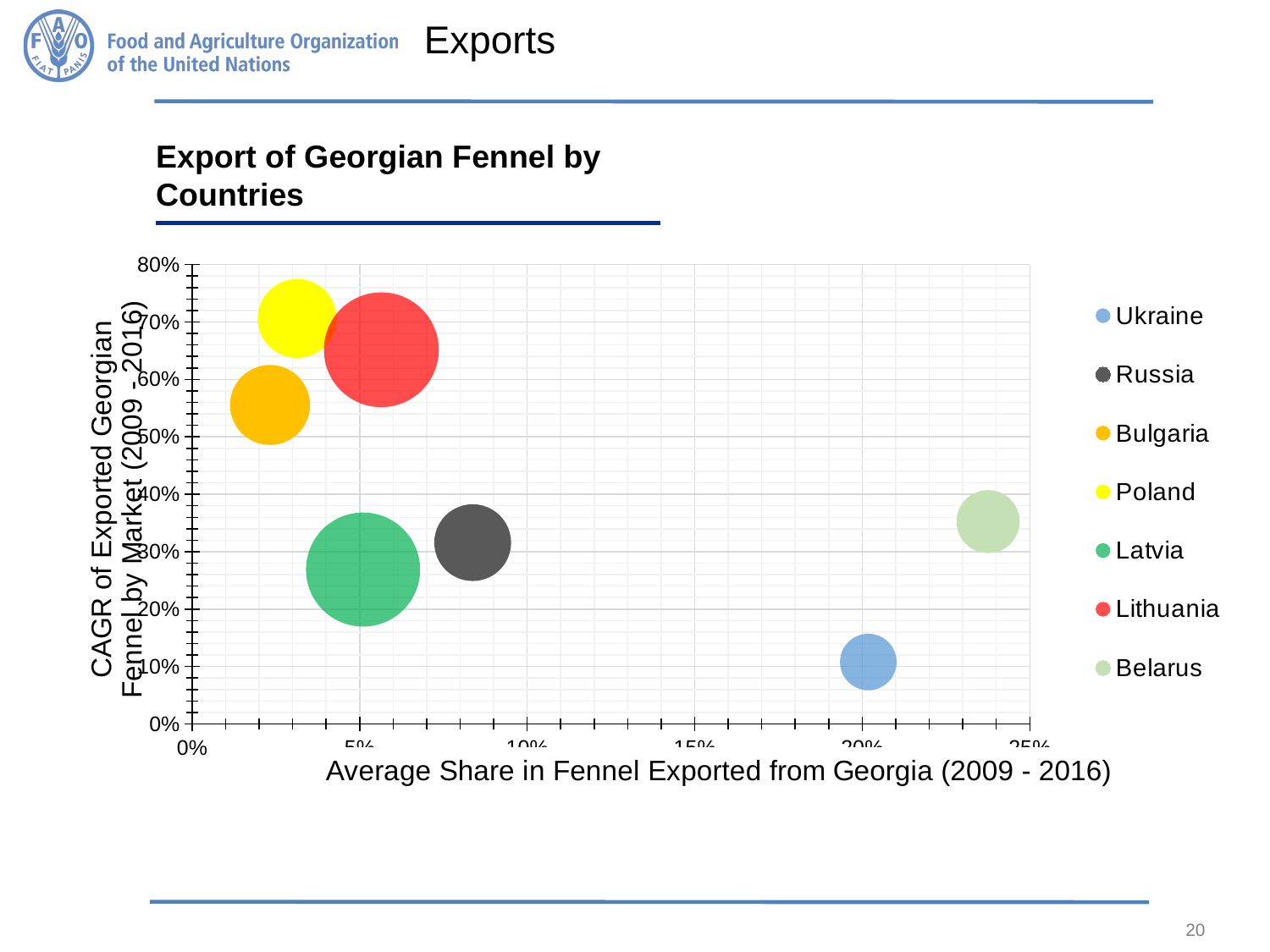
Which has a larger average share in fennel exported from Georgia, Ukraine or Russia? Ukraine What is the title of the chart? Export of Georgian Fennel by Countries Is the CAGR value for Poland greater or less than 60%? greater What kind of chart is shown on the slide? Bubble chart Is the CAGR value for Ukraine greater or less than 20%? less Which country has the highest CAGR of exported Georgian fennel? Poland How many countries does the legend list? 7 Which country has the highest average share in fennel exported from Georgia? Belarus Is the average share value for Belarus greater or less than 20%? greater Which has a higher CAGR of exported Georgian fennel, Lithuania or Latvia? Lithuania Which country has the lowest CAGR of exported Georgian fennel? Ukraine